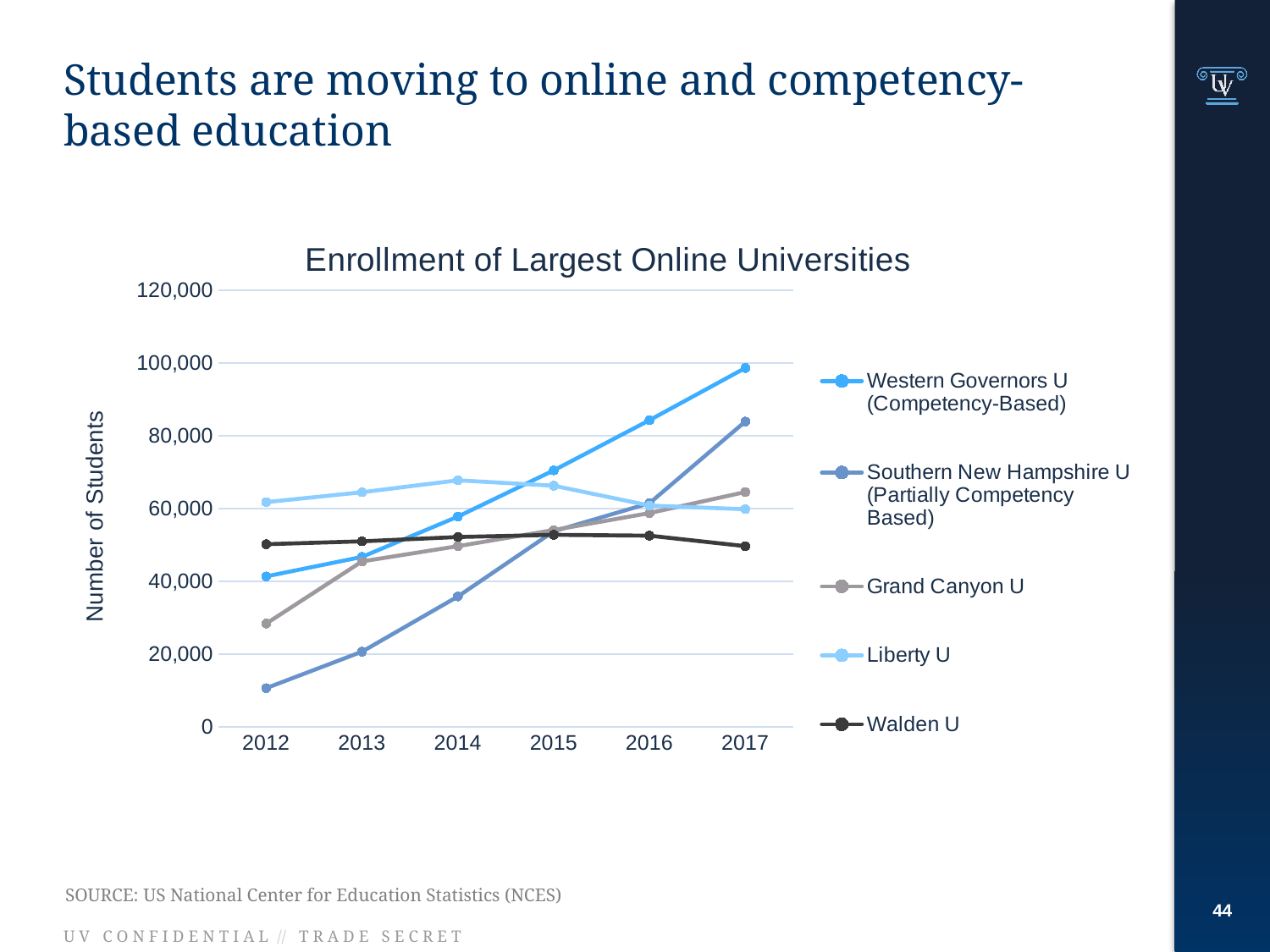
Does the enrollment for Western Governors U rise or fall from 2012 to 2017? rise Which university has the highest enrollment in 2017? Western Governors U (Competency-Based) How many years are shown on the x axis? 6 Does the enrollment for Liberty U rise or fall from 2014 to 2017? fall Is the 2017 enrollment for Western Governors U greater or less than 80,000? greater In 2016, which has the larger enrollment: Western Governors U or Liberty U? Western Governors U Is the 2012 enrollment for Southern New Hampshire U greater or less than 20,000? less What kind of chart is shown on the slide? Line chart How many series does the legend list? 5 Which university has the highest enrollment in 2012? Liberty U Which university has the lowest enrollment in 2012? Southern New Hampshire U (Partially Competency Based) What is the title of the chart? Enrollment of Largest Online Universities